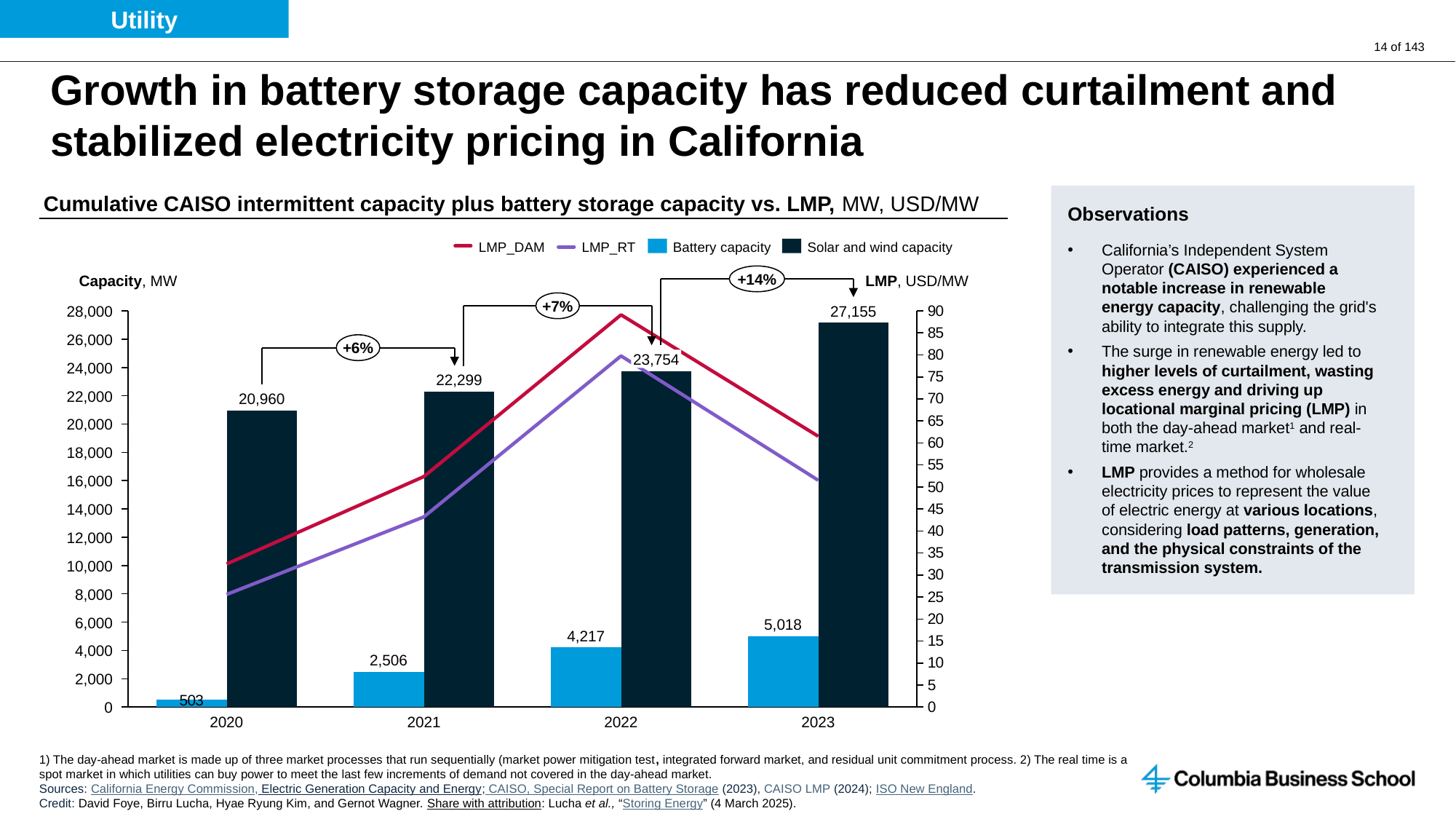
Which year has the larger battery capacity, 2021 or 2022? 2022 What percentage change is annotated between the 2022 and 2023 solar and wind capacity bars? +14% How many years are shown on the x axis? 4 Is the LMP_DAM value for 2022 greater or less than 85? greater In which year is battery capacity lowest? 2020 What is the difference between solar and wind capacity in 2023 and in 2022? 3,401 What is the solar and wind capacity in 2023? 27,155 In which year is solar and wind capacity highest? 2023 How many series does the legend list? 4 What is the difference between battery capacity in 2023 and in 2022? 801 Is the LMP_RT value for 2020 greater or less than 30? less What is the battery capacity in 2021? 2,506